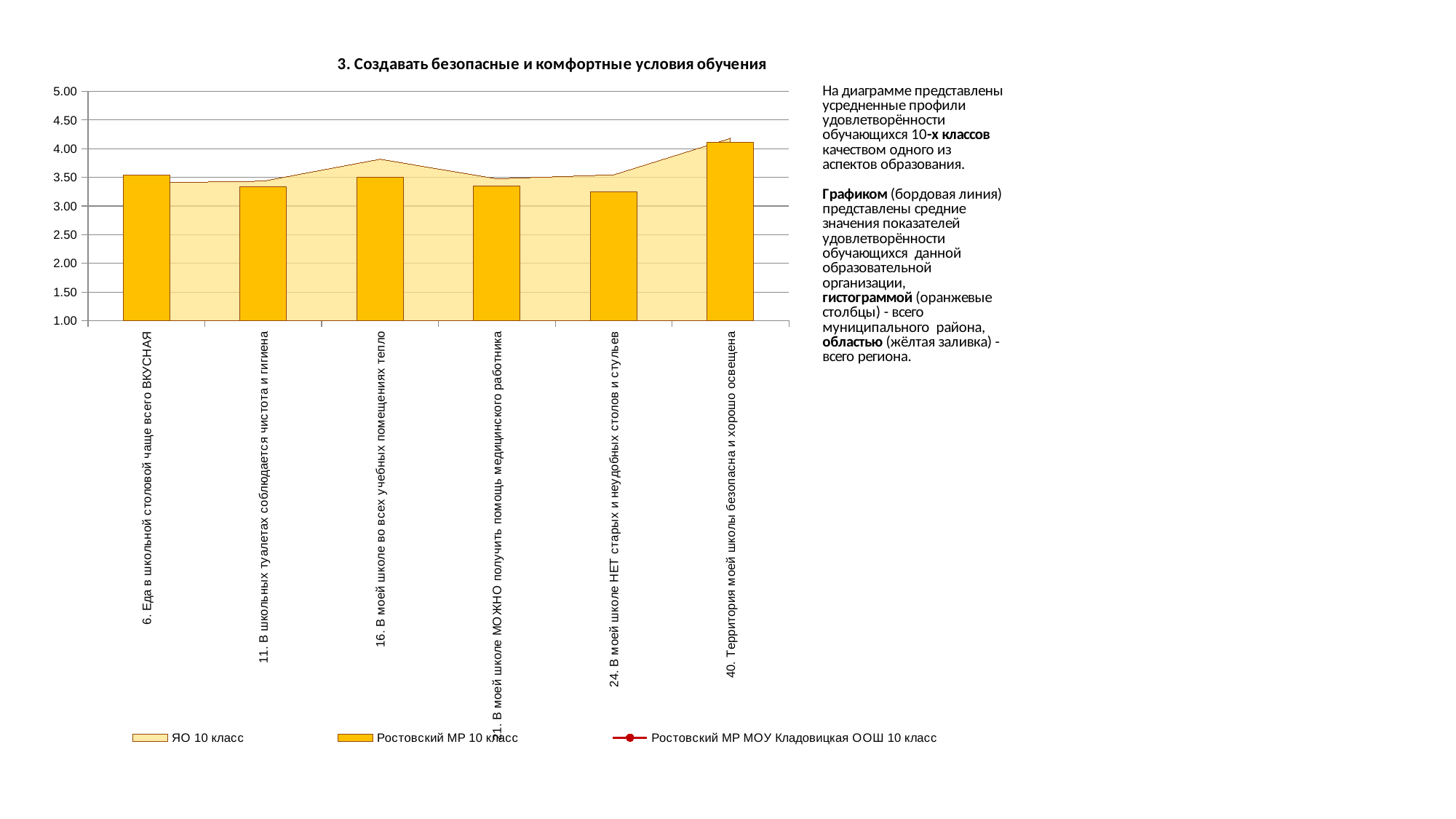
Which category has the highest bar for Ростовский МР 10 класс? 40. Территория моей школы безопасна и хорошо освещена What is the title of the chart? 3. Создавать безопасные и комфортные условия обучения Which bar is taller for Ростовский МР 10 класс: category 6 or category 24? category 6 Is the bar value for Ростовский МР 10 класс in category 11 greater or less than 3.50? less Is the ЯО 10 класс area value in category 16 greater or less than 3.50? greater How many series does the legend list? 3 Which bar is taller for Ростовский МР 10 класс: category 40 or category 11? category 40 Is the bar value for Ростовский МР 10 класс in category 24 greater or less than 3.50? less Which series is drawn as orange bars? Ростовский МР 10 класс What kind of chart is this? combination of bar, area and line chart How many categories are shown on the x axis? 6